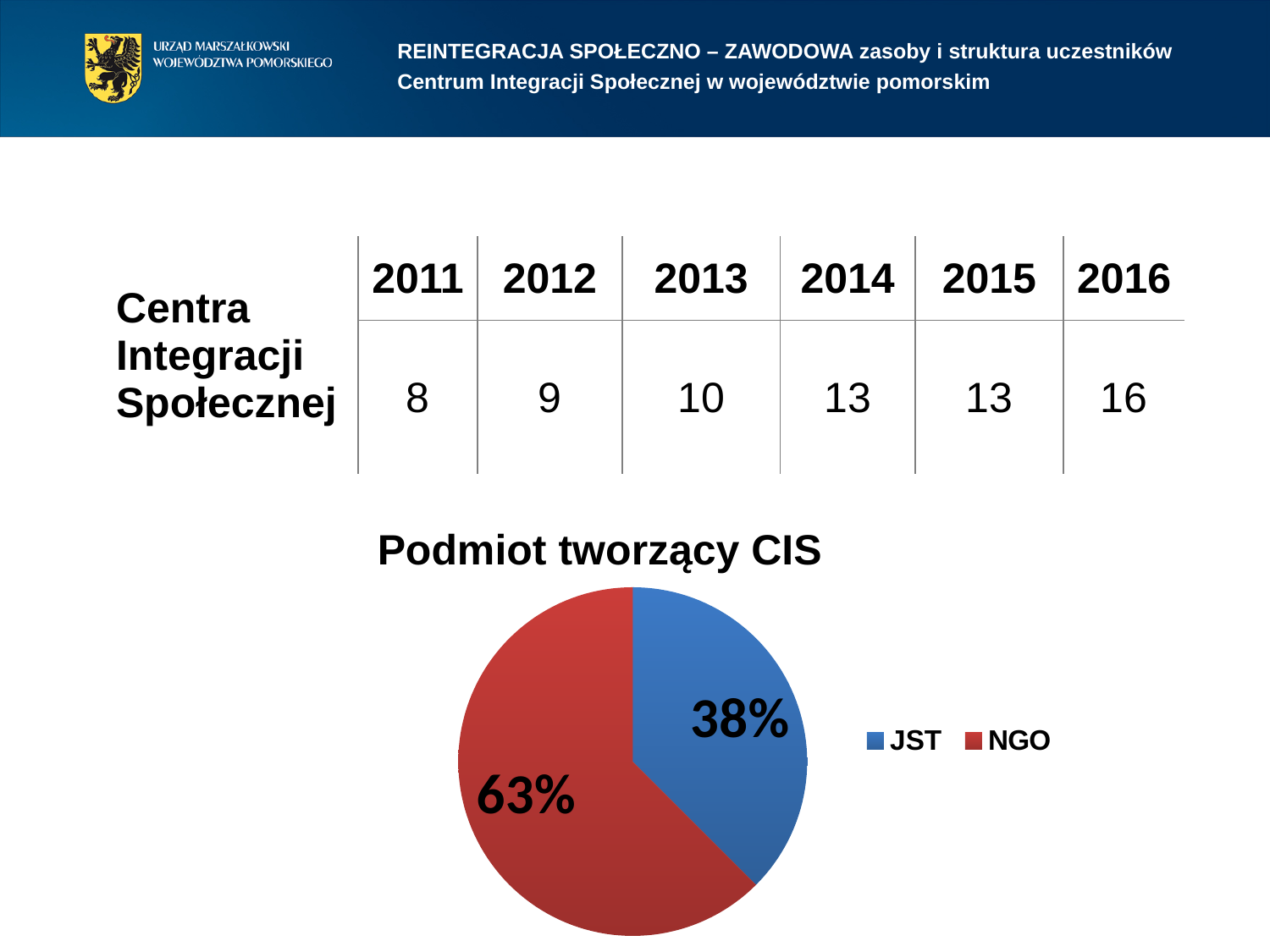
In the pie chart "Podmiot tworzący CIS", what share is labelled for JST? 38% How many slices does the pie chart "Podmiot tworzący CIS" have? 2 In the pie chart "Podmiot tworzący CIS", which category has the largest slice? NGO In the pie chart "Podmiot tworzący CIS", what share is labelled for NGO? 63% In the pie chart "Podmiot tworzący CIS", is the share for JST greater or less than 50%? less In the pie chart "Podmiot tworzący CIS", by how many percentage points does the NGO share exceed the JST share? 25 percentage points In the pie chart "Podmiot tworzący CIS", which category has the smallest slice? JST In the pie chart "Podmiot tworzący CIS", what colour is the NGO slice? red What is the title of the pie chart on the slide? Podmiot tworzący CIS In the pie chart "Podmiot tworzący CIS", which is larger, the JST slice or the NGO slice? NGO How many entries does the legend of the pie chart "Podmiot tworzący CIS" list? 2 What kind of chart is shown under the title "Podmiot tworzący CIS"? pie chart